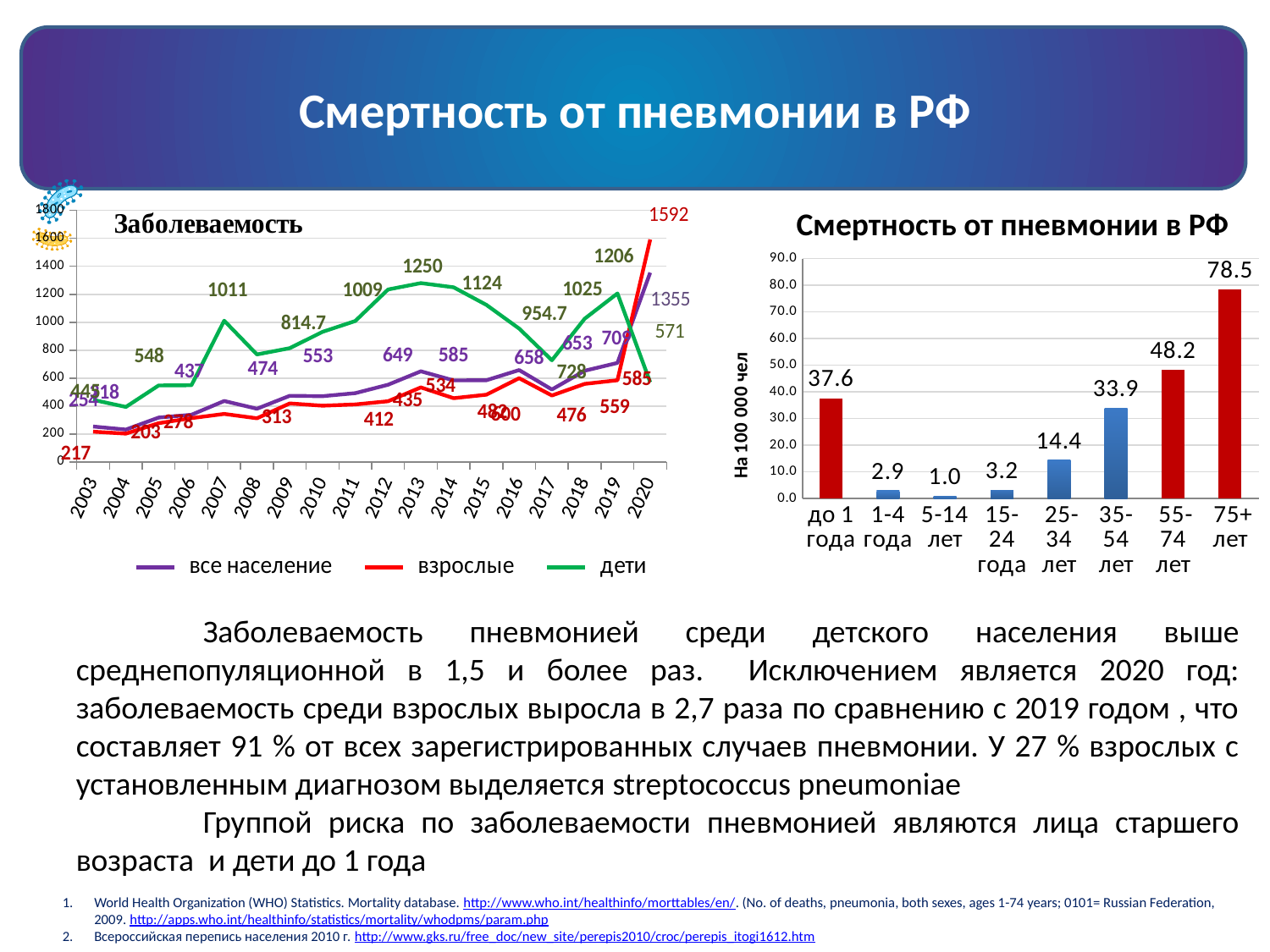
In the chart titled 'Заболеваемость', what is the value for 'взрослые' in 2020? 1592 In the chart titled 'Смертность от пневмонии в РФ', which is larger: the value for 'до 1 года' or the value for '35-54 лет'? до 1 года In the chart titled 'Смертность от пневмонии в РФ', what is the value for the 'до 1 года' age group? 37.6 What kind of chart is the one titled 'Заболеваемость'? line chart In the chart titled 'Заболеваемость', how many series does the legend list? 3 In the chart titled 'Смертность от пневмонии в РФ', what is the value for the '75+ лет' age group? 78.5 In the chart titled 'Смертность от пневмонии в РФ', how many age groups are shown? 8 What kind of chart is the one titled 'Смертность от пневмонии в РФ'? bar chart In the chart titled 'Смертность от пневмонии в РФ', what is the difference between the values for '75+ лет' and '55-74 лет'? 30.3 In the chart titled 'Смертность от пневмонии в РФ', which age group has the highest value? 75+ лет In the chart titled 'Заболеваемость', what is the value for 'дети' in 2020? 571 In the chart titled 'Смертность от пневмонии в РФ', which age group has the lowest value? 5-14 лет